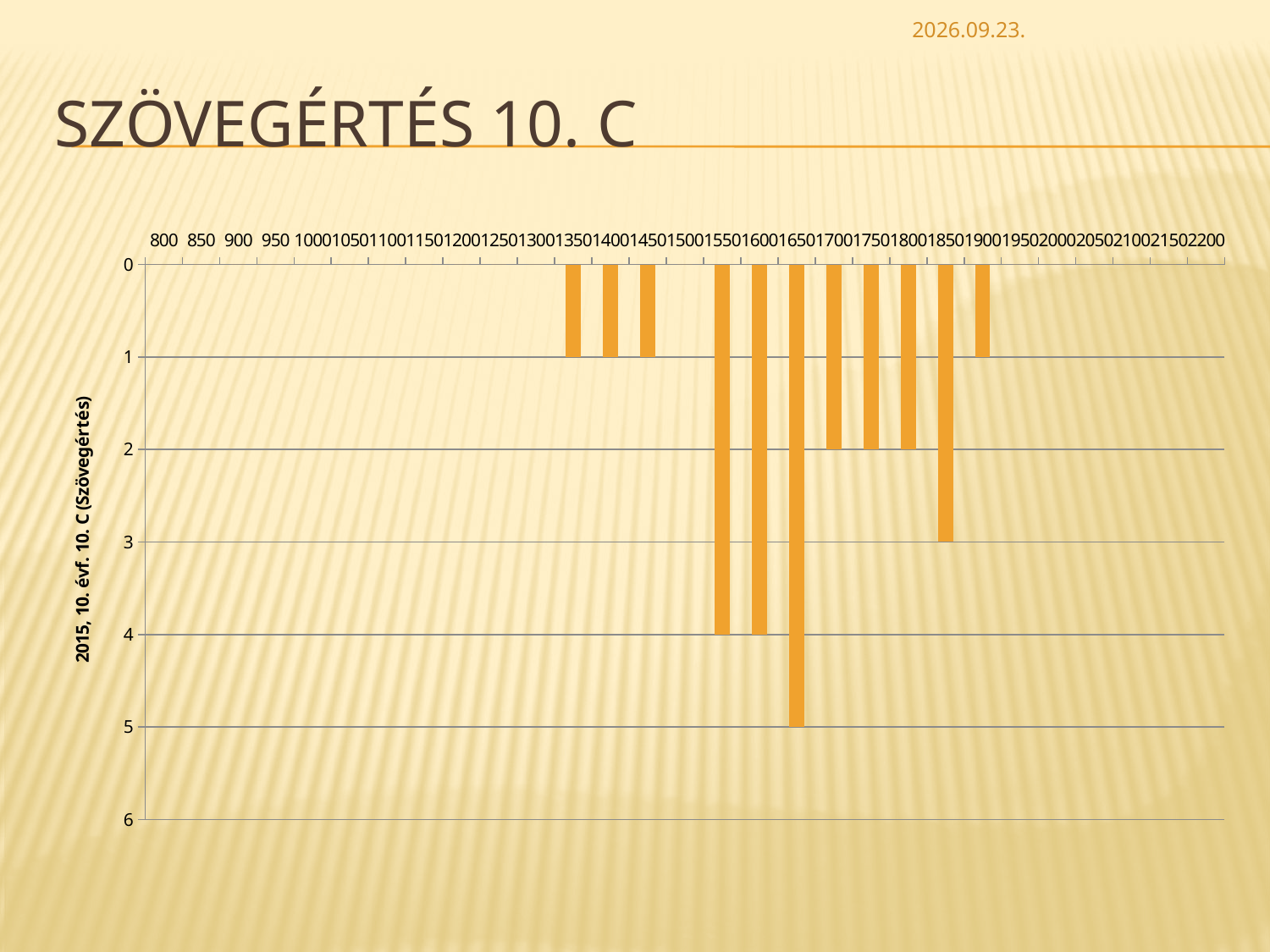
What is the value for the 1900 category? 1 How many categories have a bar with a non-zero value? 11 What is the title of the slide containing the chart? Szövegértés 10. C What is the value for the 1650 category? 5 What is the value for the 1850 category? 3 Which category has the highest value? 1650 What kind of chart is shown on the slide? bar chart What is the label on the vertical axis of the chart? 2015, 10. évf. 10. C (Szövegértés) What is the value for the 1550 category? 4 What is the difference between the values for 1650 and 1700? 3 Which is larger, the value for 1600 or the value for 1800? 1600 What is the difference between the values for 1850 and 1350? 2